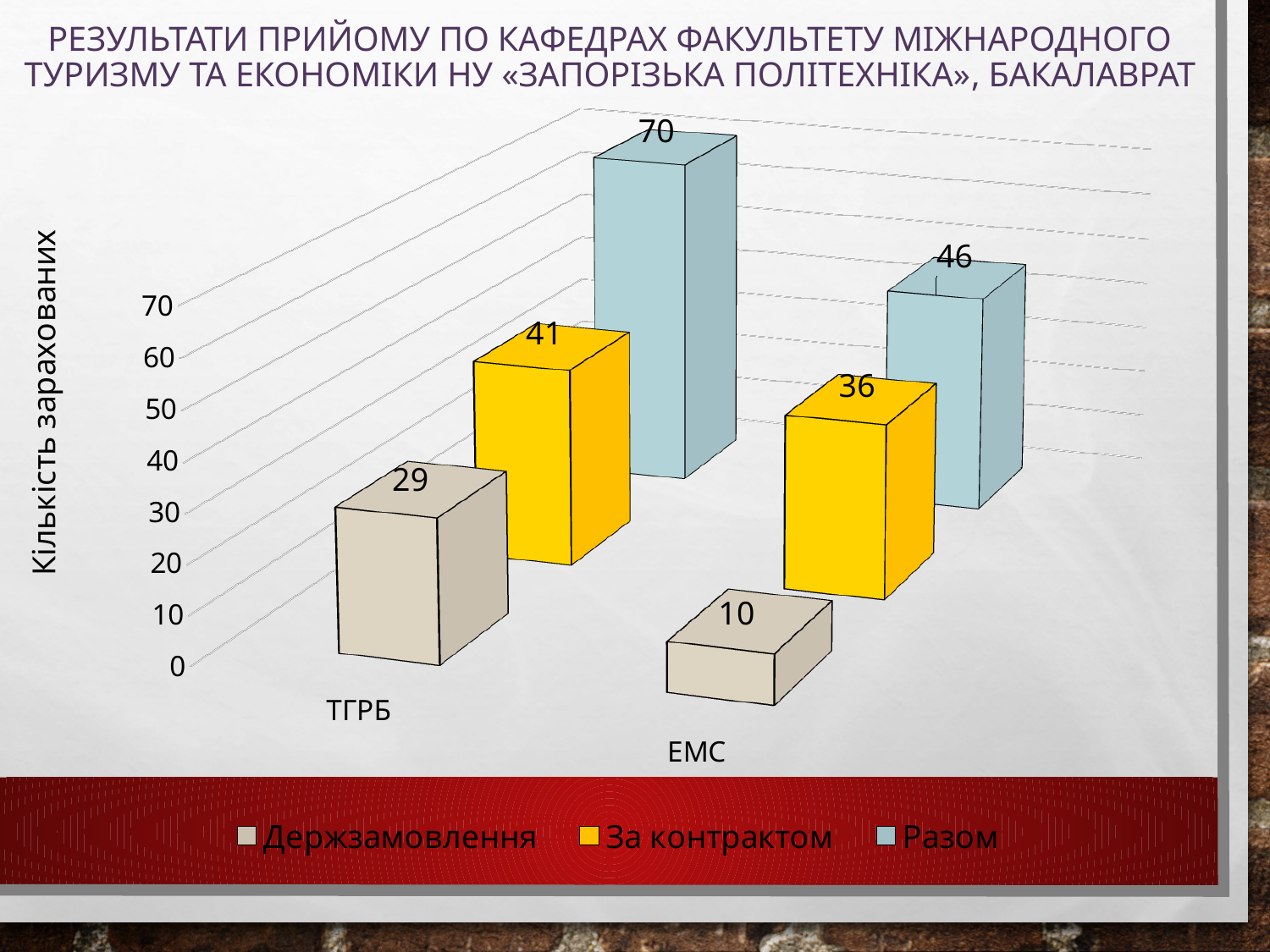
What is the value of Держзамовлення for ТГРБ? 29 What is the value of Держзамовлення for ЕМС? 10 What is the difference between the Разом values for ТГРБ and ЕМС? 24 How many series does the legend list? 3 Which is larger: За контрактом for ТГРБ or За контрактом for ЕМС? ТГРБ What kind of chart is shown on the slide? Bar chart Which category has the highest Разом value? ТГРБ Which category has the lowest Держзамовлення value? ЕМС What is the label of the vertical axis? Кількість зарахованих How many categories are shown on the x axis? 2 What is the value of Разом for ТГРБ? 70 What is the value of За контрактом for ЕМС? 36